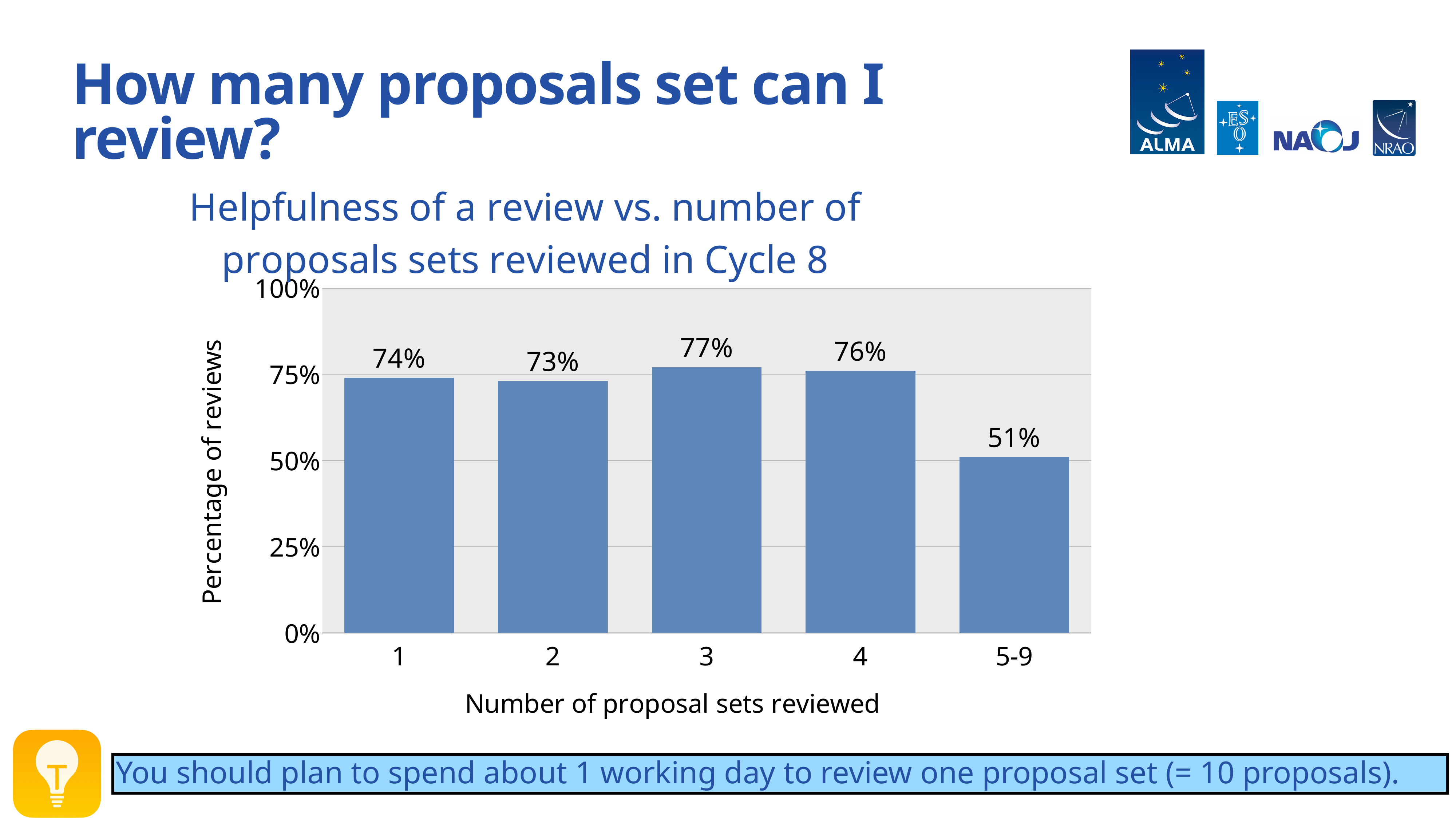
What percentage is shown for 3 proposal sets reviewed? 77% What is the title of the chart? Helpfulness of a review vs. number of proposals sets reviewed in Cycle 8 Which number of proposal sets reviewed has the highest percentage of reviews? 3 What is the value for the 5-9 proposal sets category? 51% Which category has the lowest percentage of reviews? 5-9 What percentage of reviews is shown for 1 proposal set reviewed? 74% What is the difference between the values for 3 and 2 proposal sets reviewed? 4% How many categories are shown on the x axis? 5 What is the difference between the values for 4 proposal sets and 5-9 proposal sets? 25% Is the value for 5-9 proposal sets greater or less than 75%? less What kind of chart is shown on the slide? bar chart Which is larger, the value for 1 proposal set or the value for 2 proposal sets? 1 proposal set